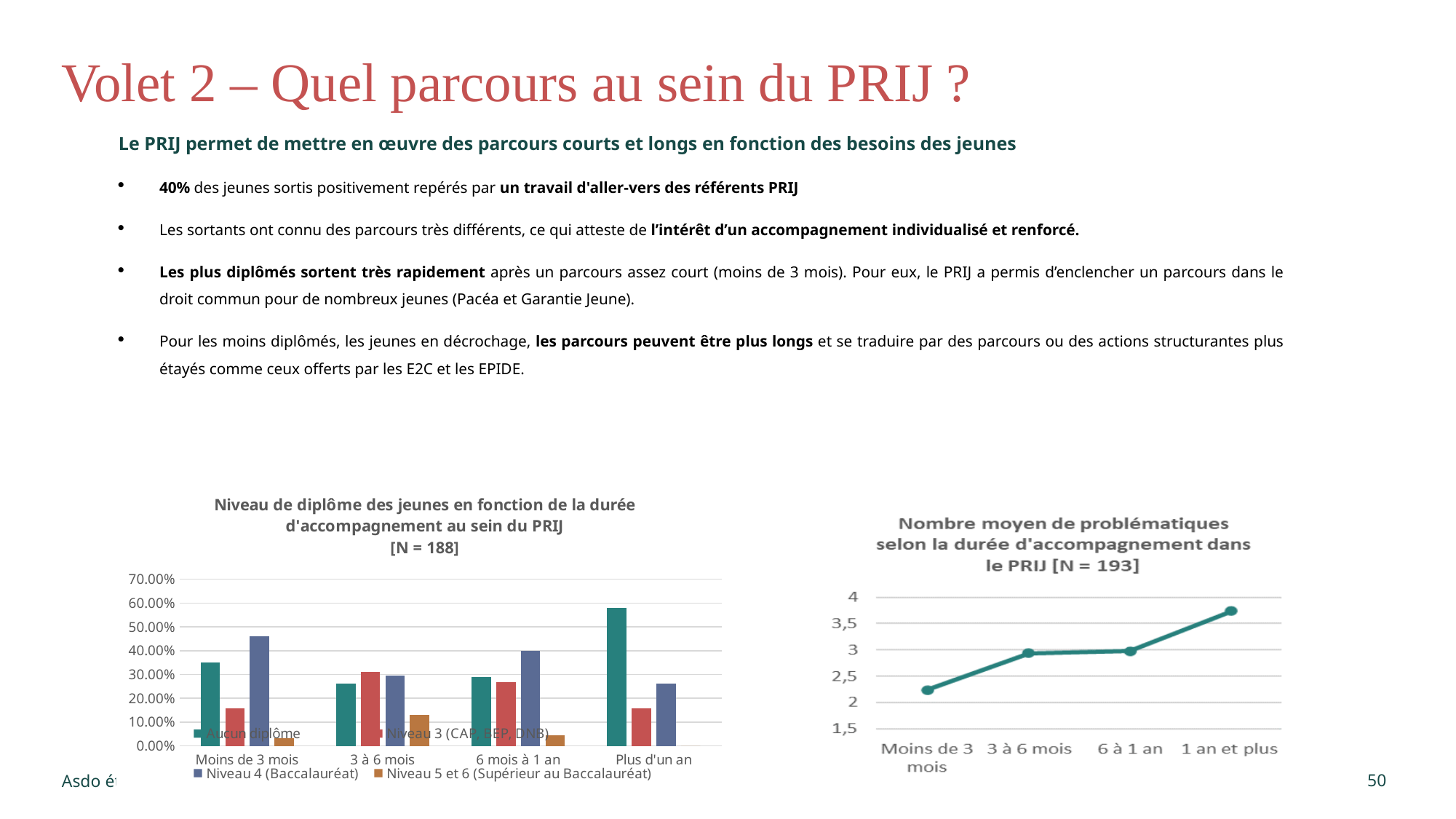
In the bar chart on the left, is the value for 'Niveau 5 et 6 (Supérieur au Baccalauréat)' in the 'Moins de 3 mois' category greater or less than 10.00%? less In the bar chart on the left, how many duration categories are shown on the x axis? 4 In the line chart on the right, how many data points are plotted? 4 What kind of chart is the chart titled 'Nombre moyen de problématiques selon la durée d'accompagnement dans le PRIJ'? line chart In the line chart on the right, is the value for '1 an et plus' greater or less than 3.5? greater In the bar chart on the left, how many series does the legend list? 4 What kind of chart is the chart titled 'Niveau de diplôme des jeunes en fonction de la durée d'accompagnement au sein du PRIJ'? bar chart In the line chart on the right, do the values rise or fall from 'Moins de 3 mois' to '1 an et plus'? rise In the bar chart on the left, in the 'Plus d'un an' category, which is larger: 'Aucun diplôme' or 'Niveau 3 (CAP, BEP, DNB)'? Aucun diplôme In the bar chart on the left, is the value for 'Aucun diplôme' in the 'Plus d'un an' category greater or less than 50.00%? greater In the line chart on the right, which duration category has the lowest value? Moins de 3 mois In the bar chart on the left, which duration category has the highest value for 'Aucun diplôme'? Plus d'un an